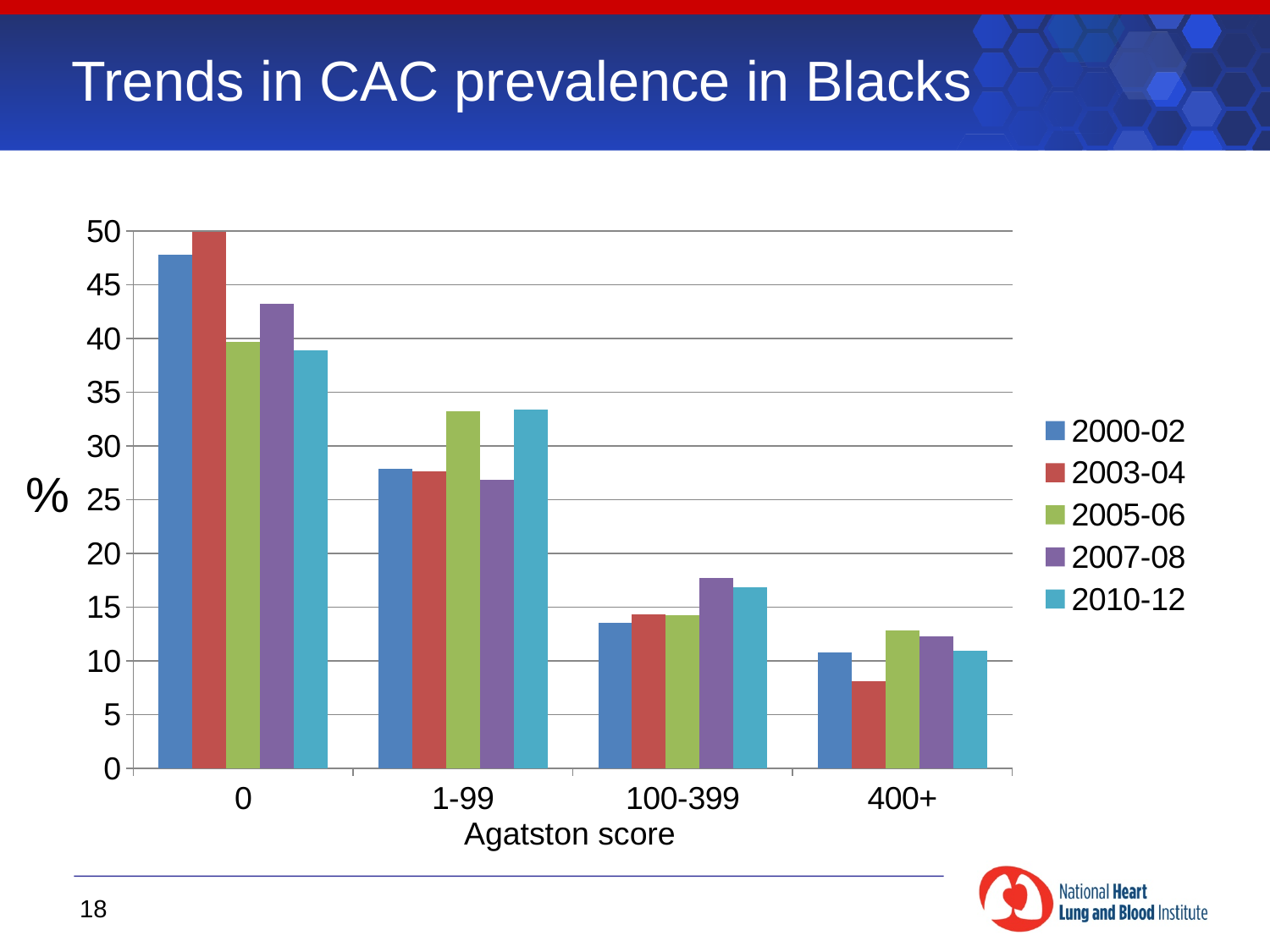
How many Agatston score categories are shown on the x axis? 4 Is the value for 2003-04 in the 400+ Agatston score category greater or less than 10? less For the 2000-02 series, do the values rise or fall as the Agatston score category increases from 0 to 400+? fall What kind of chart is shown on the slide? bar chart What is the title of the x axis? Agatston score In the 100-399 Agatston score category, which is larger: the value for 2007-08 or the value for 2000-02? 2007-08 In the 400+ Agatston score category, which period has the lowest bar? 2003-04 How many series does the legend list? 5 Is the value for 2005-06 in the 1-99 Agatston score category greater or less than 30? greater In the Agatston score 0 category, which is larger: the value for 2007-08 or the value for 2005-06? 2007-08 Is the value for 2003-04 in the Agatston score 0 category greater or less than 45? greater In the Agatston score 0 category, which period has the highest bar? 2003-04